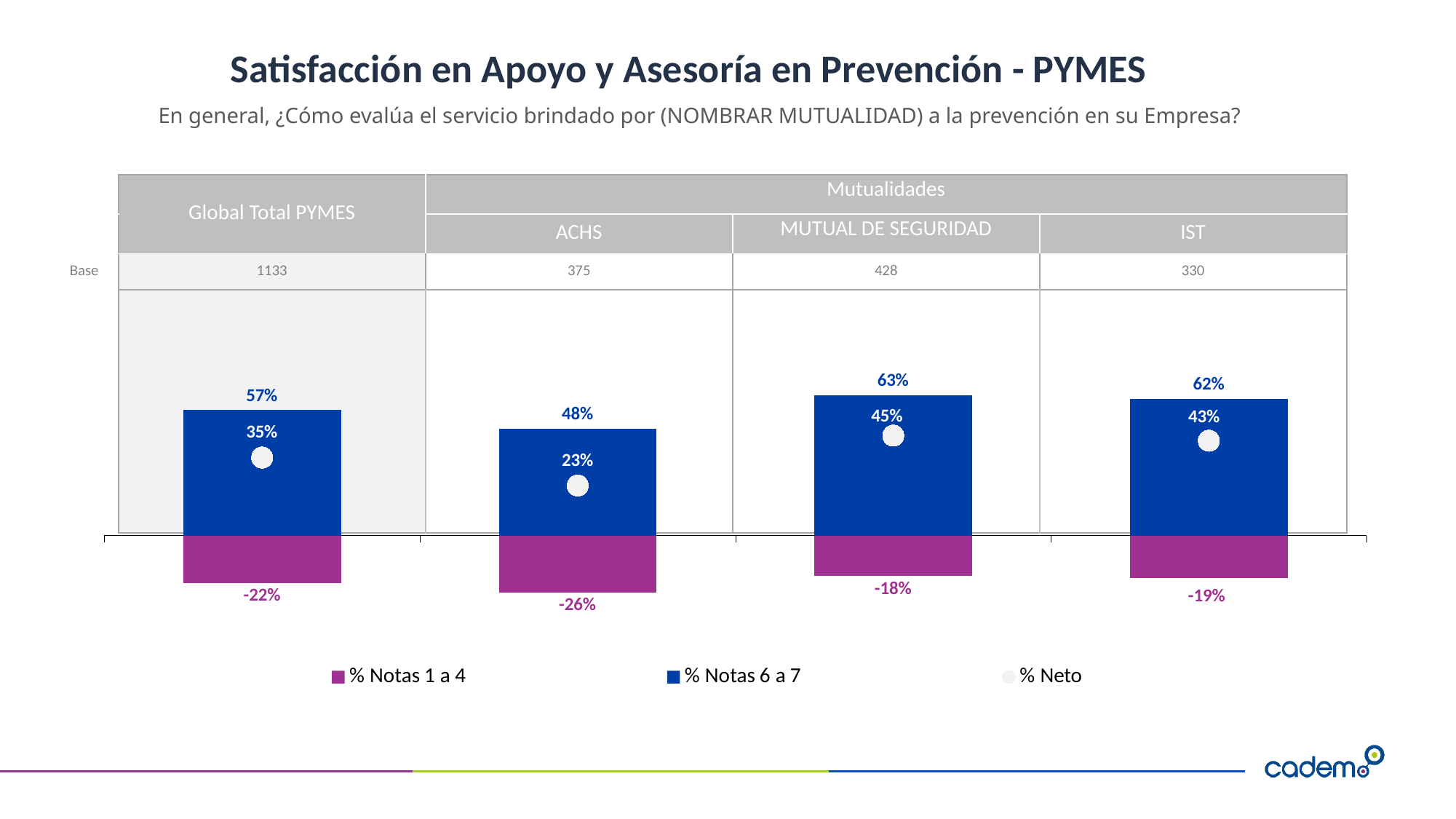
What is the % Notas 1 a 4 value for MUTUAL DE SEGURIDAD? -18% Which category has the highest % Notas 6 a 7 value? MUTUAL DE SEGURIDAD How many series does the legend list? 3 Which category has the lowest % Neto value? ACHS What is the % Neto value for Global Total PYMES? 35% Which is larger, the % Neto value for IST or for MUTUAL DE SEGURIDAD? MUTUAL DE SEGURIDAD What is the difference between the % Notas 6 a 7 values for MUTUAL DE SEGURIDAD and ACHS? 15% How many categories are shown on the x axis of the chart? 4 What is the % Neto value for IST? 43% What kind of chart is shown on the slide? Bar chart What is the base (number of respondents) shown for ACHS? 375 What is the % Notas 6 a 7 value for ACHS? 48%